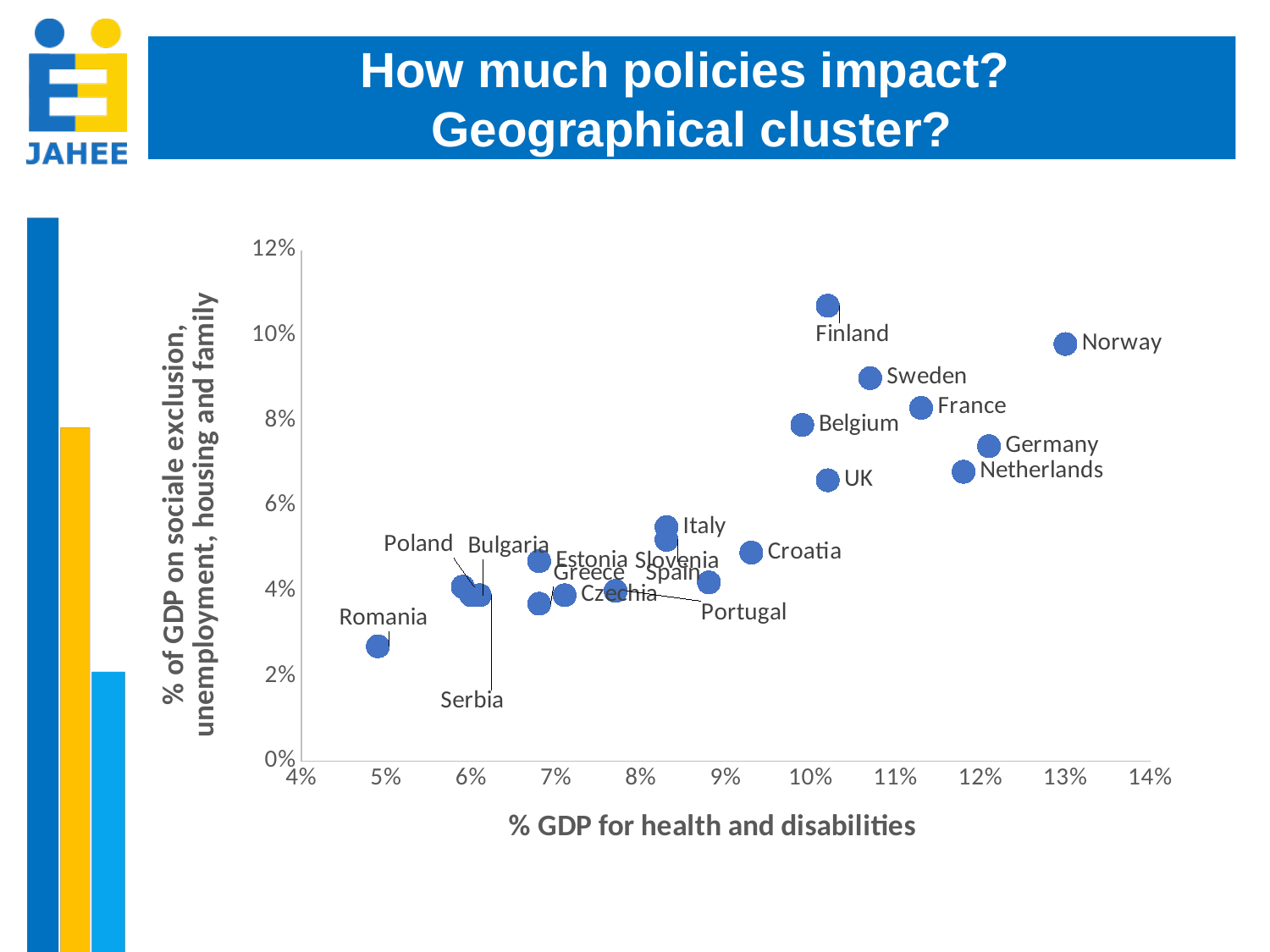
Is the vertical-axis value for Croatia greater or less than 6%? less Which country has the lowest value on the horizontal axis? Romania Which country has the highest value on the vertical axis (% of GDP on social exclusion, unemployment, housing and family)? Finland Is the vertical-axis value for Romania greater or less than 4%? less What kind of chart is shown on the slide? scatter chart Which country has the highest value on the horizontal axis (% GDP for health and disabilities)? Norway Which country has the lowest value on the vertical axis? Romania Is the horizontal-axis value for Norway greater or less than 12%? greater Which has the higher vertical-axis value, Sweden or France? Sweden What is the title of the horizontal axis? % GDP for health and disabilities Which has the higher horizontal-axis value, Germany or Netherlands? Germany